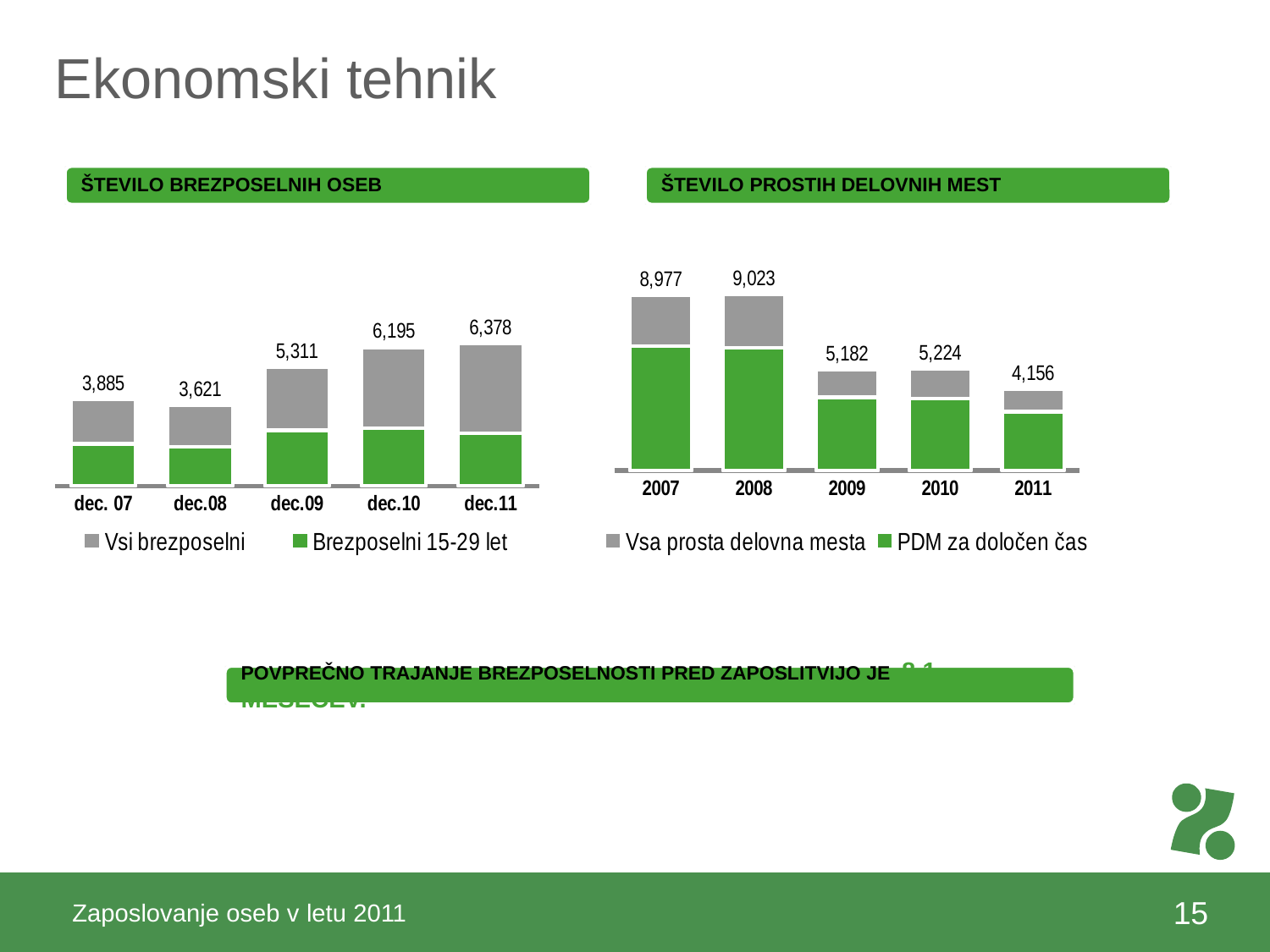
How many periods are shown on the x axis of the chart titled ŠTEVILO BREZPOSELNIH OSEB? 5 In the chart titled ŠTEVILO BREZPOSELNIH OSEB, what is the labelled value for dec. 07? 3,885 What kind of chart is the chart titled ŠTEVILO PROSTIH DELOVNIH MEST? bar chart How many series does the legend of the chart titled ŠTEVILO PROSTIH DELOVNIH MEST list? 2 In the chart titled ŠTEVILO BREZPOSELNIH OSEB, what is the labelled value for dec.09? 5,311 In the chart titled ŠTEVILO PROSTIH DELOVNIH MEST, what is the labelled value for 2011? 4,156 In the chart titled ŠTEVILO PROSTIH DELOVNIH MEST, what is the difference between the labelled values for 2008 and 2009? 3,841 In the chart titled ŠTEVILO PROSTIH DELOVNIH MEST, which is larger, the labelled value for 2007 or for 2010? 2007 In the chart titled ŠTEVILO PROSTIH DELOVNIH MEST, which year has the highest labelled value? 2008 In the chart titled ŠTEVILO BREZPOSELNIH OSEB, which series is shown in green? Brezposelni 15-29 let In the chart titled ŠTEVILO BREZPOSELNIH OSEB, which period has the lowest labelled value? dec.08 In the chart titled ŠTEVILO BREZPOSELNIH OSEB, what is the difference between the labelled values for dec.11 and dec.10? 183